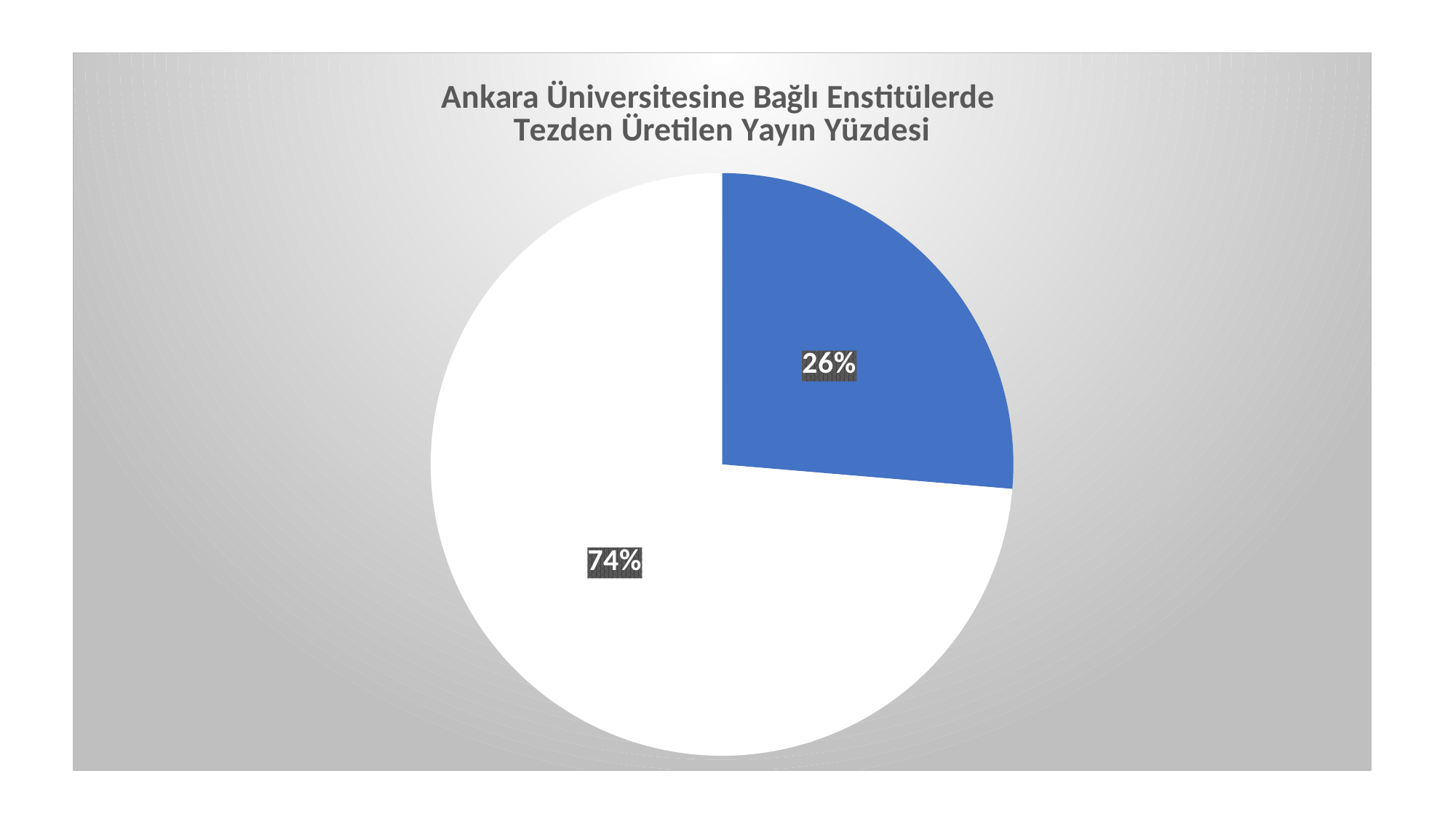
What kind of chart is shown on the slide? pie chart Which slice of the pie chart is the smallest? the blue slice (26%) Which is larger, the blue slice or the white slice? the white slice What share of the pie does the blue slice represent? 26% What is the difference in percentage points between the white slice and the blue slice? 48 What percentage is shown on the blue slice of the pie chart? 26% Which slice of the pie chart is the largest? the white slice (74%) How many slices does the pie chart have? 2 What percentage is shown on the white slice of the pie chart? 74% What is the title of the chart? Ankara Üniversitesine Bağlı Enstitülerde Tezden Üretilen Yayın Yüzdesi What colour is the slice labelled 26%? blue